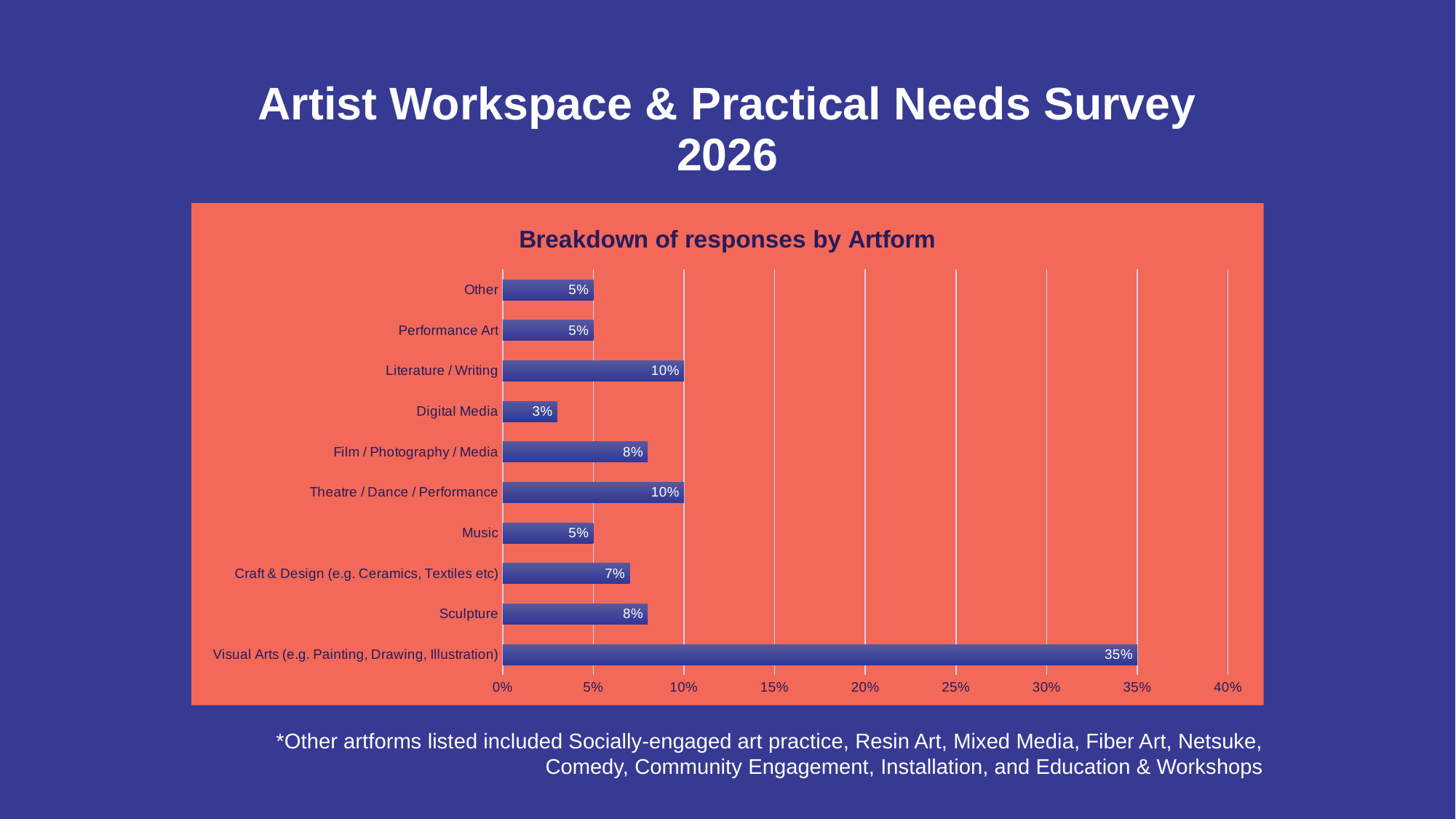
What is the value for Digital Media? 3% What is the difference between the values for Visual Arts and Sculpture? 27% Which artform has the lowest share of responses? Digital Media Which is larger, the value for Film / Photography / Media or the value for Performance Art? Film / Photography / Media Is the value for Theatre / Dance / Performance greater or less than 5%? greater Which artform has the highest share of responses? Visual Arts (e.g. Painting, Drawing, Illustration) What kind of chart is shown on the slide? Bar chart What is the title of the chart? Breakdown of responses by Artform What percentage of responses is shown for Visual Arts (e.g. Painting, Drawing, Illustration)? 35% What is the value for Craft & Design (e.g. Ceramics, Textiles etc)? 7% How many artform categories are shown in the chart? 10 What is the difference between the values for Literature / Writing and Music? 5%